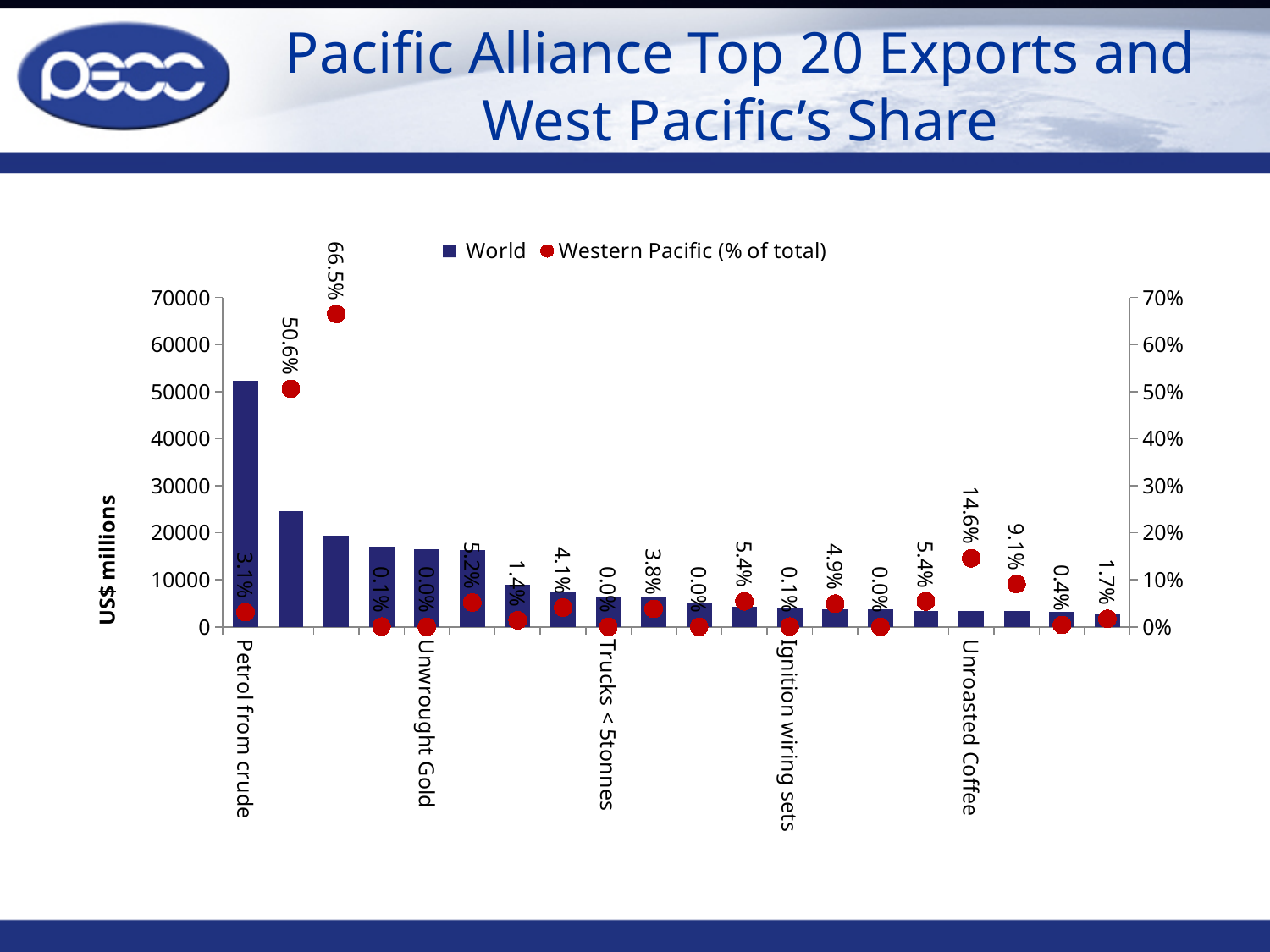
What is the Western Pacific share (% of total) for Ignition wiring sets? 0.1% What is the highest Western Pacific share (% of total) shown on the chart? 66.5% Is the World export value for Unroasted Coffee greater or less than 10000 US$ millions? less What is the Western Pacific share (% of total) for Unwrought Gold? 0.0% Is the World export value for Petrol from crude greater or less than 50000 US$ millions? greater Which has the larger Western Pacific share, Unroasted Coffee or Petrol from crude? Unroasted Coffee What is the Western Pacific share (% of total) for Petrol from crude? 3.1% By how many percentage points does the Western Pacific share for Unroasted Coffee exceed that for Petrol from crude? 11.5 percentage points Do the World export values (bars) rise or fall from left to right across the chart? fall How many series does the legend list? 2 How many export categories (bars) are plotted on the chart? 20 What is the Western Pacific share (% of total) for Unroasted Coffee? 14.6%